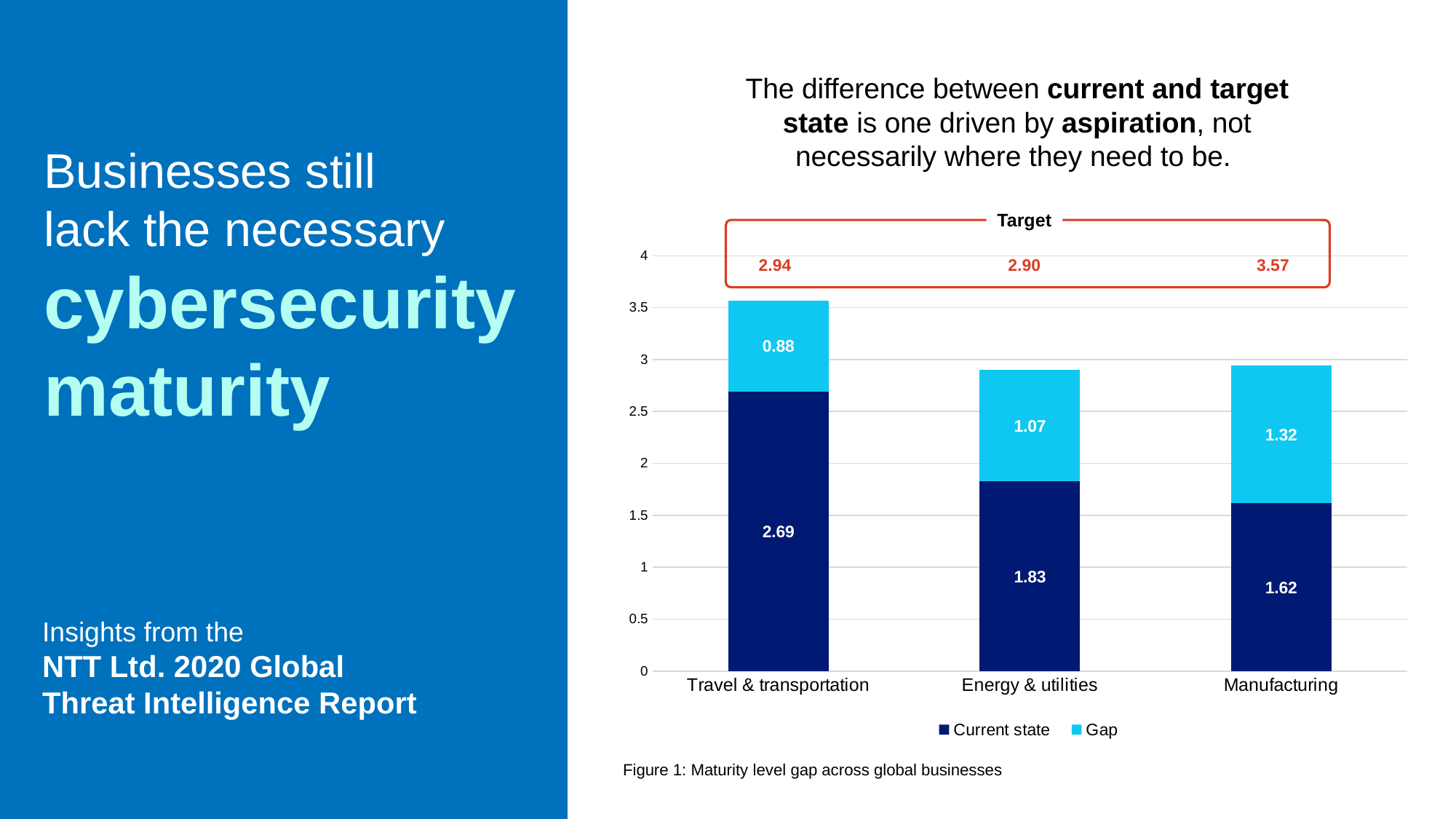
What is the Gap value for Energy & utilities? 1.07 Which category has the lowest Current state value? Manufacturing How many series does the legend list? 2 What kind of chart is shown on the slide? Stacked bar chart Which category has the highest Current state value? Travel & transportation What is the Gap value for Manufacturing? 1.32 What is the difference between the Current state values for Travel & transportation and Energy & utilities? 0.86 Which has the larger Gap value, Energy & utilities or Manufacturing? Manufacturing What is the Current state value for Travel & transportation? 2.69 Which category has the largest Gap value? Manufacturing What is the total of the stacked bar for Travel & transportation (Current state plus Gap)? 3.57 How many categories are shown on the x axis? 3